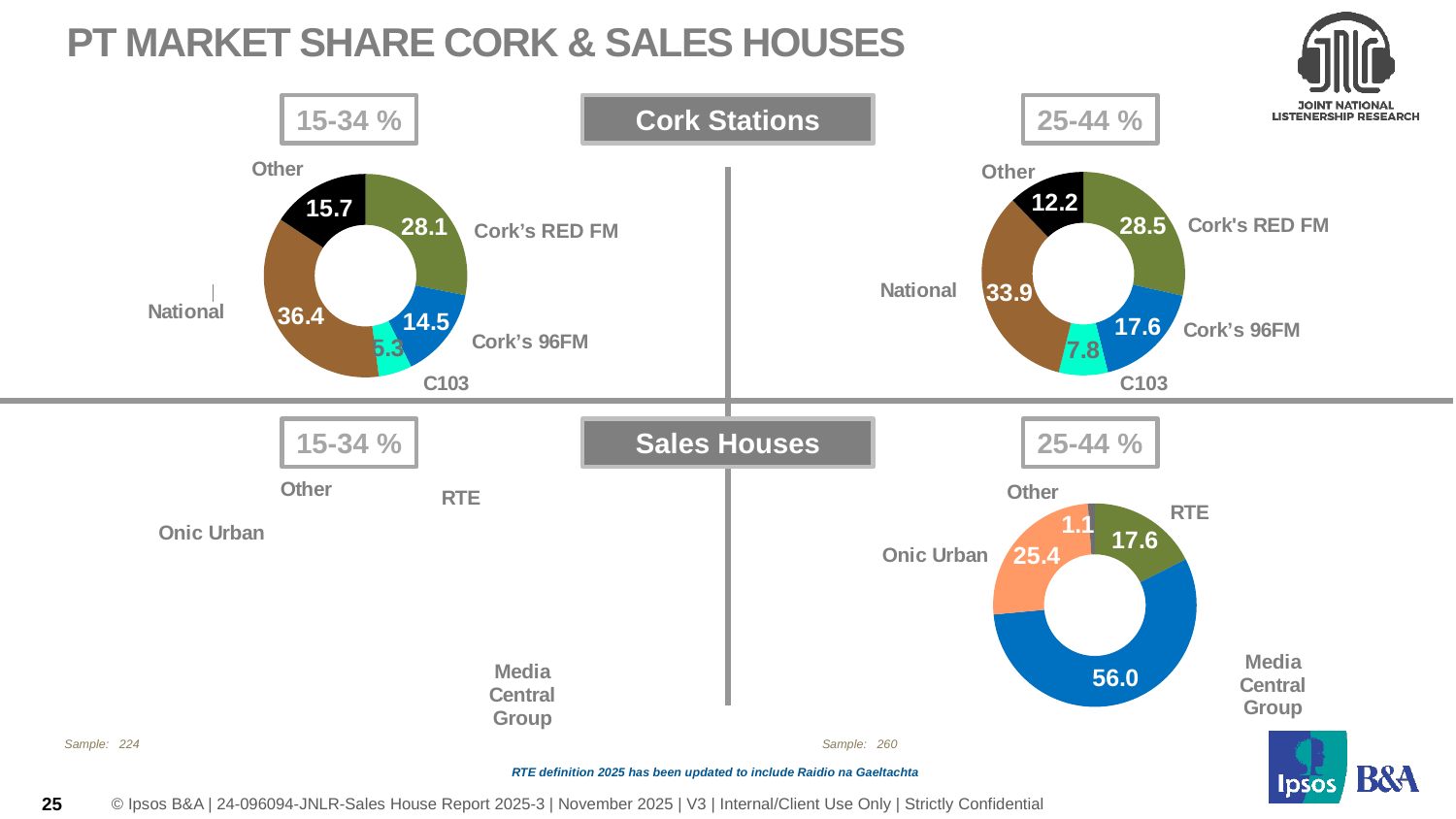
In the Sales Houses 25-44 chart, which category has the lowest value? Other How many categories are shown in the Cork Stations 25-44 chart? 5 In the Cork Stations 25-44 chart, what is the value for C103? 7.8 In the Cork Stations 15-34 chart, which category has the largest share? National In the Cork Stations 15-34 chart, what is the value for Cork's 96FM? 14.5 What type of chart is used for the Sales Houses 25-44 data? Doughnut chart In the Cork Stations 15-34 chart, which is larger, Other or Cork's 96FM? Other In the Cork Stations 25-44 chart, what is the value for Cork's RED FM? 28.5 In the Cork Stations 15-34 chart, what is the value for National? 36.4 In the Sales Houses 25-44 chart, what is the value for Media Central Group? 56.0 In the Cork Stations 25-44 chart, which category has the smallest share? C103 In the Cork Stations 25-44 chart, what is the difference between National and Cork's RED FM? 5.4